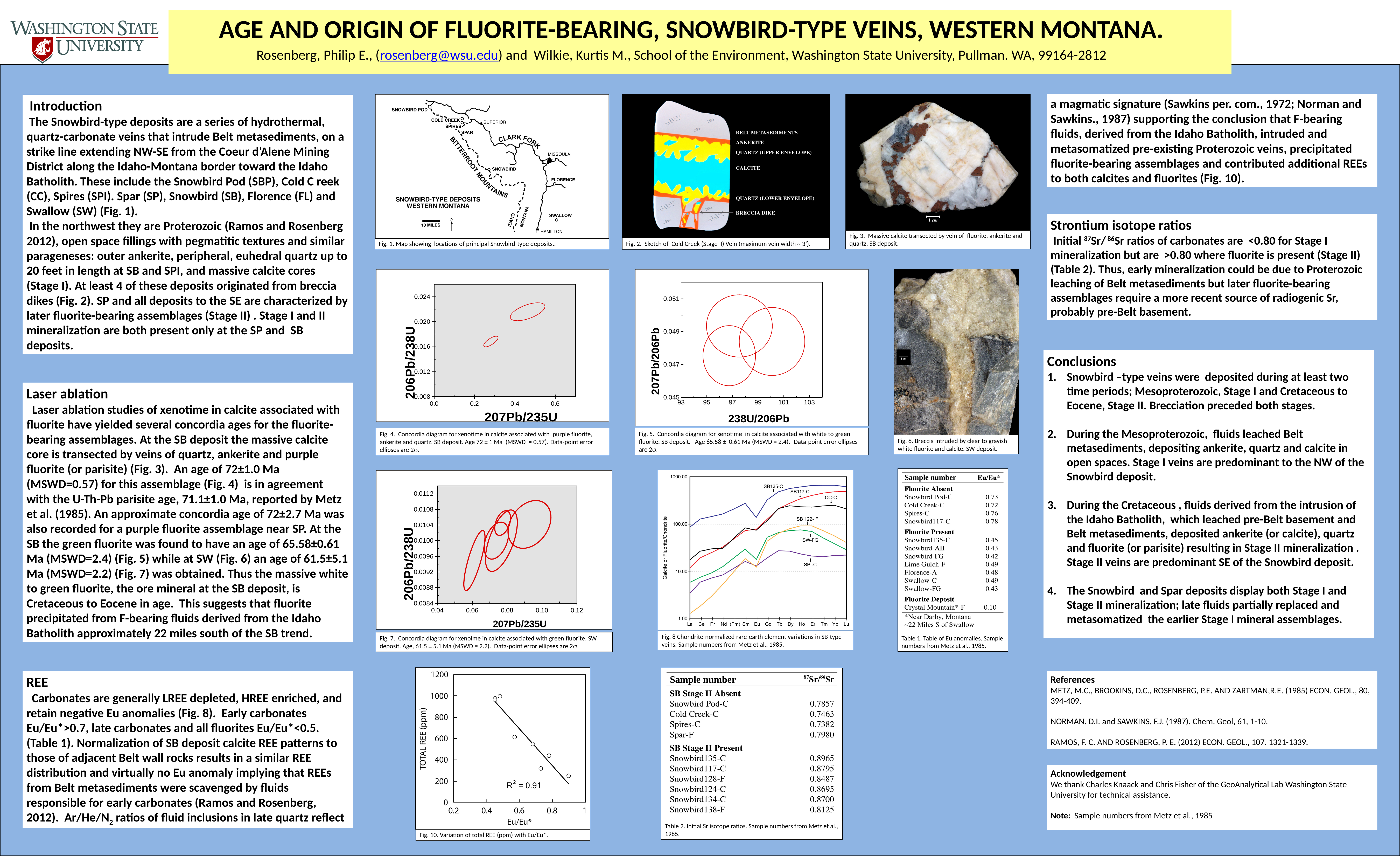
In Fig. 10, is the total REE value for the point at Eu/Eu* of about 0.9 greater or less than 400 ppm? less In Fig. 8, how many rare-earth elements are listed along the x axis? 15 In Fig. 8, is the value for SB135-C at Lu greater or less than 100? greater In Fig. 10, what is the label of the y axis? TOTAL REE (ppm) In Fig. 10, what is the label of the x axis? Eu/Eu* In Fig. 8, is the value for SPI-C at La greater or less than 10? less What kind of chart is Fig. 10? scatter plot In Fig. 10, what R-squared value is printed on the chart? R² = 0.91 In Fig. 4, how many error ellipses are plotted? 2 In Fig. 10, does total REE rise or fall as Eu/Eu* increases? fall What kind of chart is Fig. 8? line chart